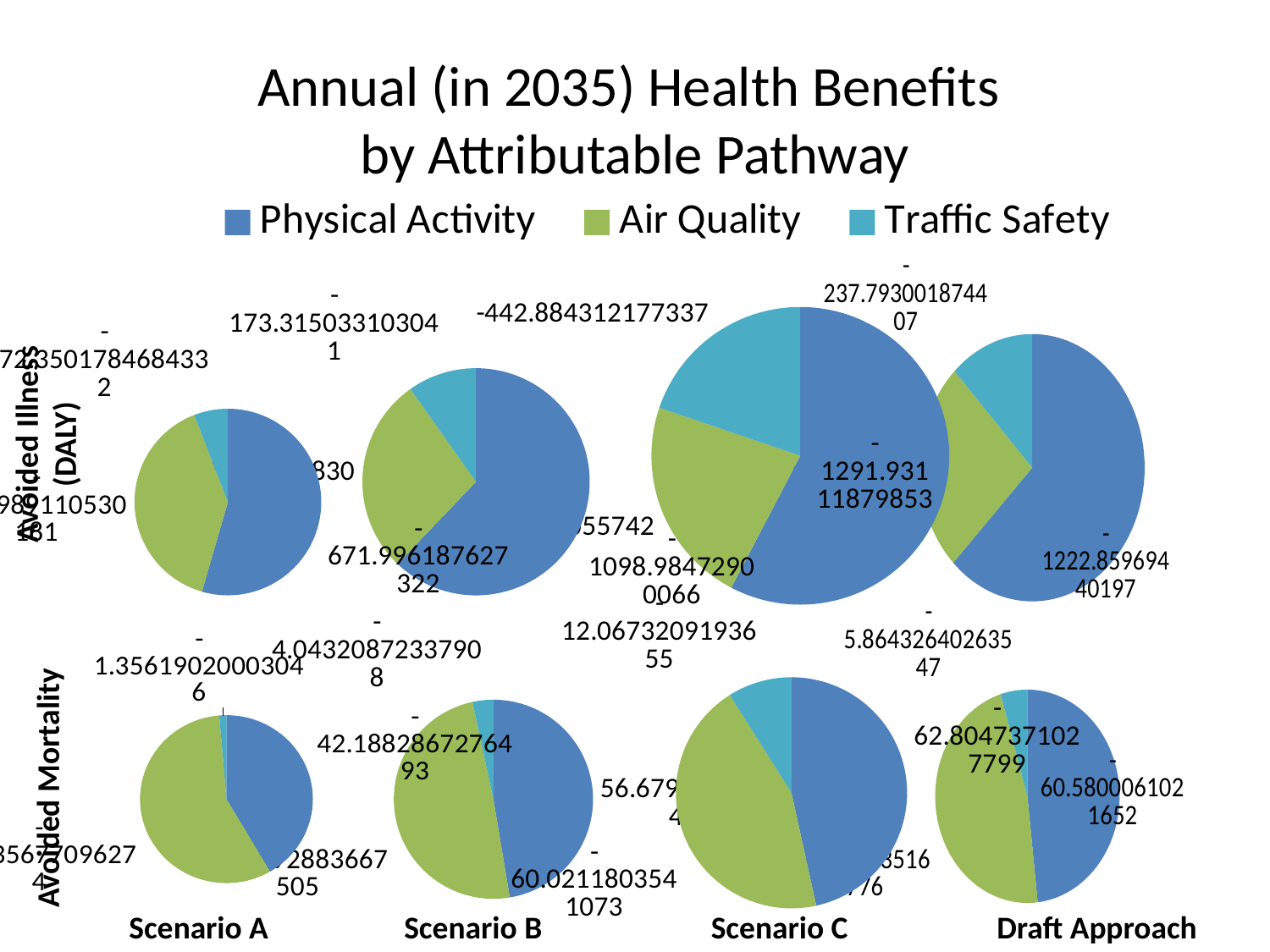
What are the three entries in the legend? Physical Activity, Air Quality, Traffic Safety What colour represents Traffic Safety in the legend? Light blue In the Scenario B Avoided Illness (DALY) pie, which slice is larger: Physical Activity or Air Quality? Physical Activity In the Scenario C Avoided Illness (DALY) pie, which pathway has the largest slice? Physical Activity In the Draft Approach Avoided Illness (DALY) pie, what value is labelled on the Physical Activity slice? -1222.85969440197 How many series does the legend list? 3 In the Scenario A Avoided Mortality pie, which pathway has the largest slice? Air Quality How many scenarios are labelled along the bottom of the chart? 4 In the Scenario A Avoided Mortality pie, which pathway has the smallest slice? Traffic Safety How many pie charts are shown on the slide? 8 In the Draft Approach Avoided Mortality pie, which slice is larger: Air Quality or Traffic Safety? Air Quality What kind of charts are shown on the slide? Pie charts